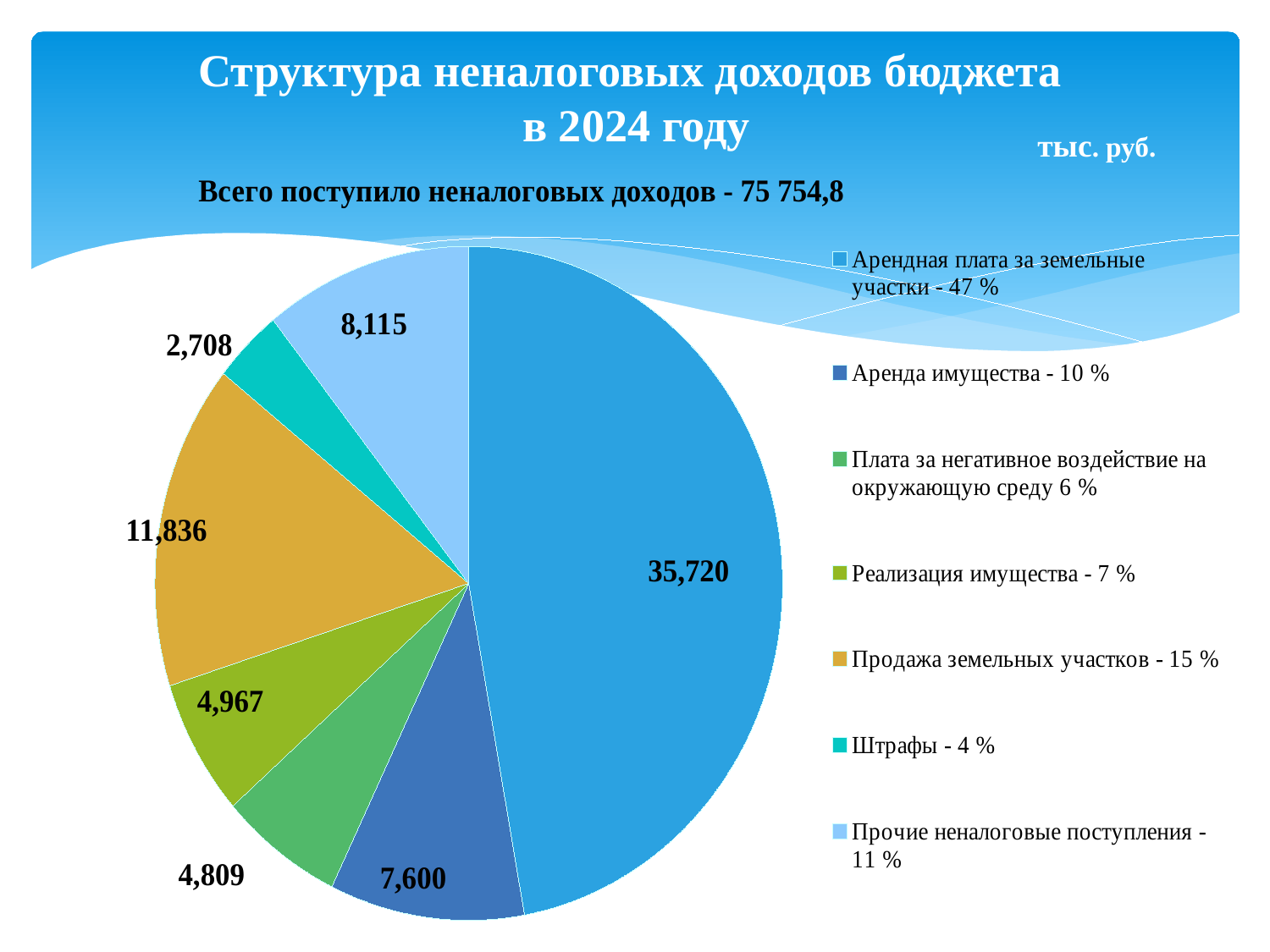
What is the value for Продажа земельных участков? 11,836 How many slices does the pie chart have? 7 What type of chart is shown on the slide? pie chart Which category has the largest slice of the pie? Арендная плата за земельные участки What share of the pie does Продажа земельных участков represent? 15 % What is the difference between the values for Арендная плата за земельные участки and Продажа земельных участков? 23,884 What is the value for Арендная плата за земельные участки? 35,720 What is the value for Прочие неналоговые поступления? 8,115 What is the value for Штрафы? 2,708 Which category has the smallest slice of the pie? Штрафы What total of non-tax revenues is stated on the slide? 75 754,8 Which is larger: the value for Аренда имущества or the value for Прочие неналоговые поступления? Прочие неналоговые поступления